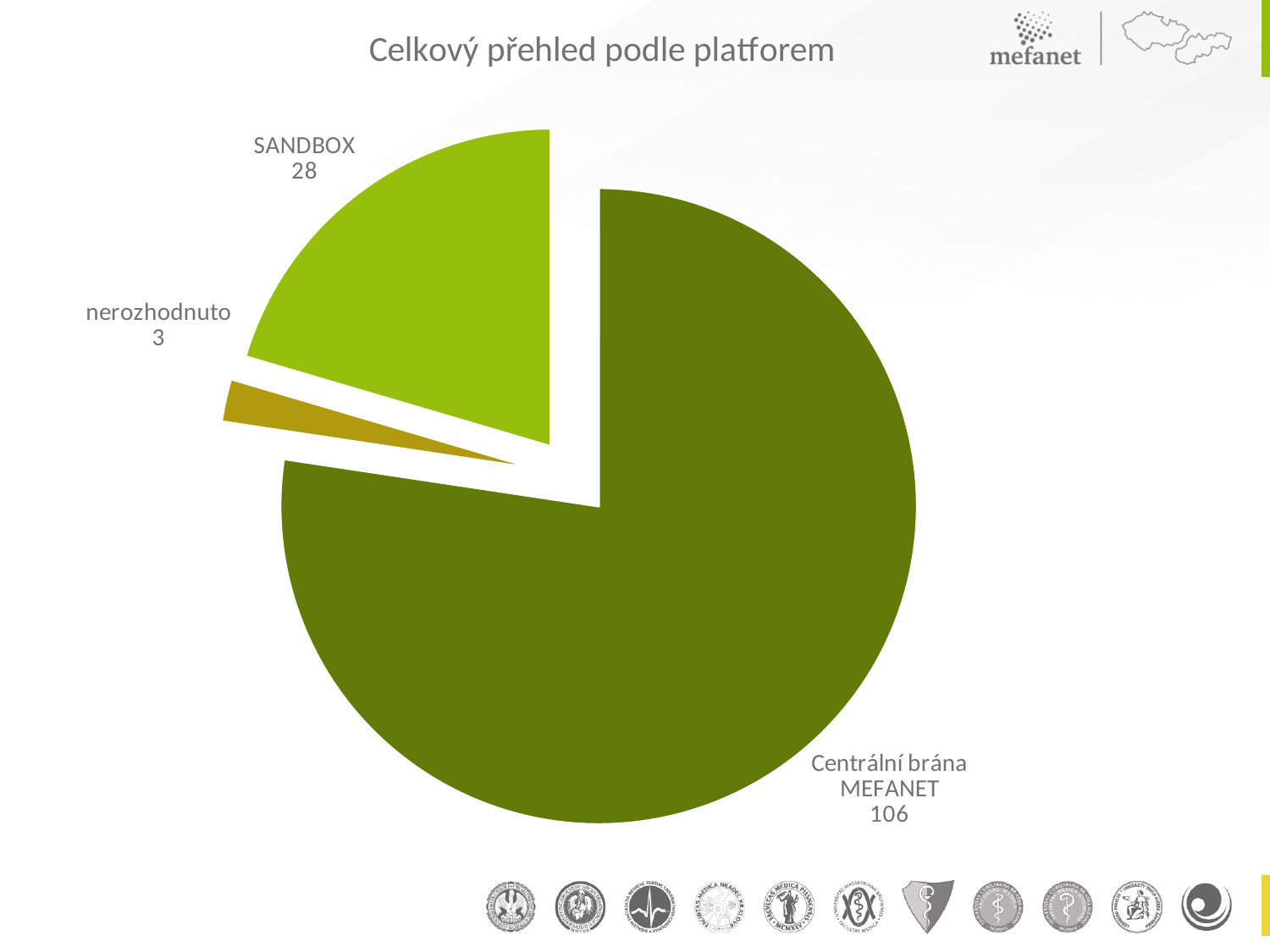
What type of chart is shown on the slide? pie chart Which is larger, the value for SANDBOX or the value for nerozhodnuto? SANDBOX What is the difference between the values for Centrální brána MEFANET and SANDBOX? 78 How many categories are shown in the pie chart? 3 What is the difference between the values for SANDBOX and nerozhodnuto? 25 What is the title of the chart? Celkový přehled podle platforem What is the value for nerozhodnuto? 3 What is the value for SANDBOX? 28 Which category has the largest slice of the pie? Centrální brána MEFANET What is the total of all slices in the pie chart? 137 What is the value for Centrální brána MEFANET? 106 Which category has the smallest slice of the pie? nerozhodnuto